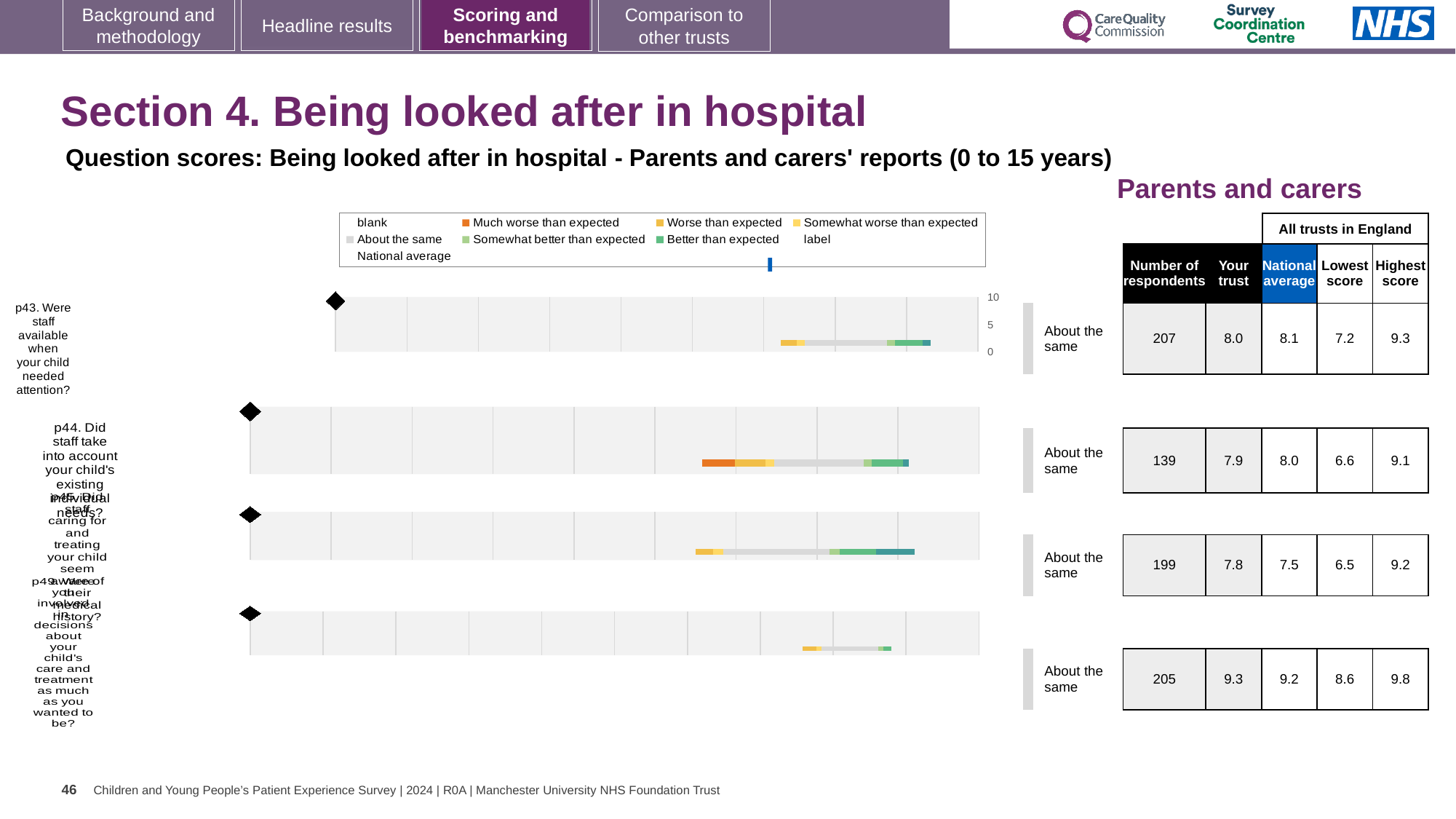
What is the title of the section shown on this slide? Section 4. Being looked after in hospital For the p43 chart, what is the 'Your trust' score? 8.0 For the p43 chart (Were staff available when your child needed attention?), what is the number of respondents shown in the table? 207 For the p44 chart, what is the lowest score among all trusts in England? 6.6 Which of the four charts has the lowest number of respondents? p44, with 139 What benchmark category is shown next to the p43 chart? About the same Which of the four charts has the highest 'Your trust' score? The bottom (fourth) chart, with 9.3 How many question charts are shown on the slide? 4 For the p43 chart, what is the difference between the highest score and the lowest score across all trusts in England? 2.1 What type of chart is used to show the question scores on this slide? bar chart For the p44 chart, which is larger: the 'Your trust' score or the national average? National average For the p44 chart (Did staff take into account your child's existing individual needs?), what is the national average score? 8.0